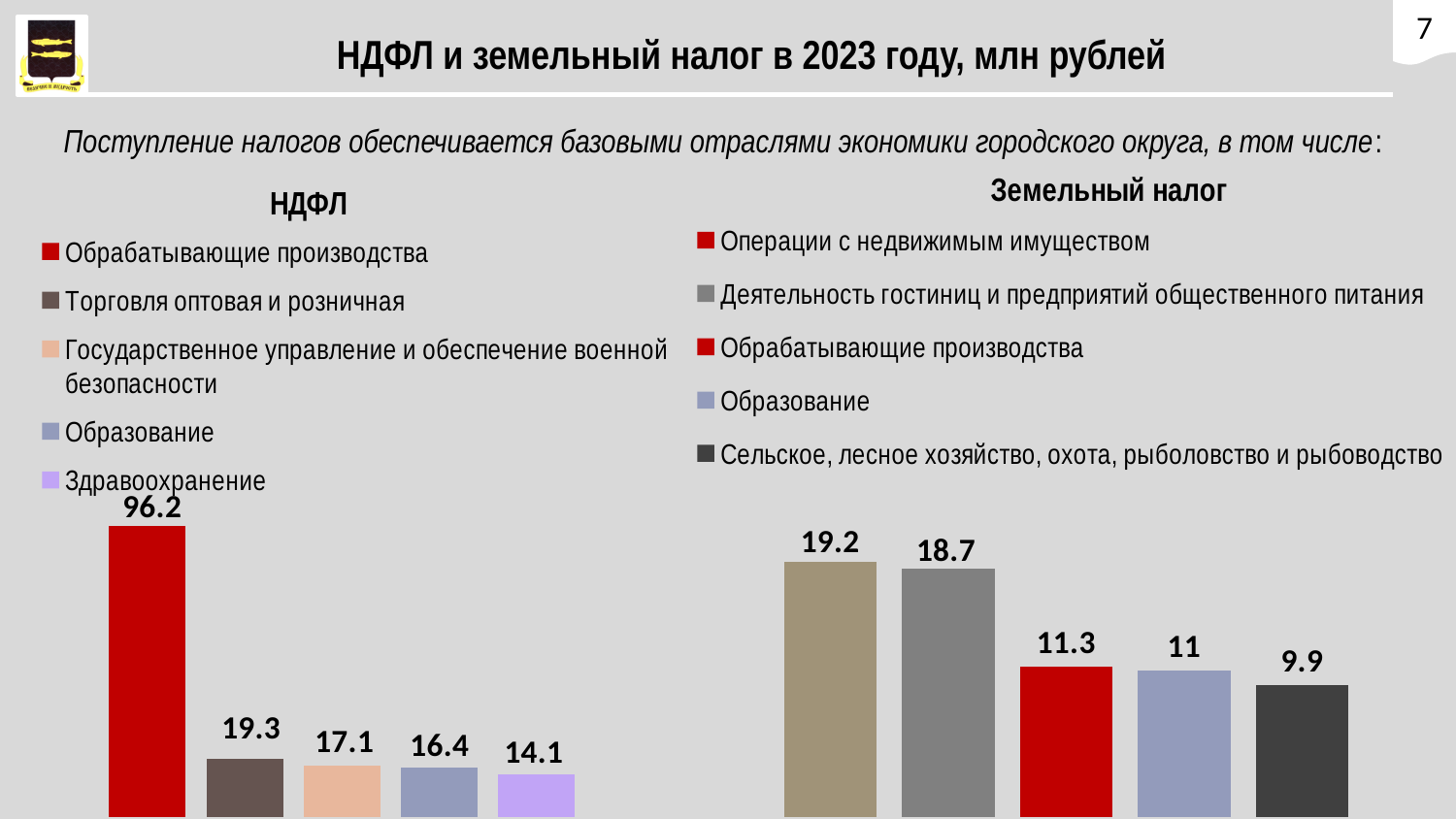
On the Земельный налог chart, what is the value of the first (leftmost) bar? 19.2 On the НДФЛ chart, what is the value for Обрабатывающие производства? 96.2 On the Земельный налог chart, what is the difference between the highest bar (19.2) and the lowest bar (9.9)? 9.3 On the НДФЛ chart, what is the difference between Торговля оптовая и розничная and Образование? 2.9 On the НДФЛ chart, which category has the lowest value? Здравоохранение On the Земельный налог chart, which is larger: Обрабатывающие производства or Образование? Обрабатывающие производства On the Земельный налог chart, what is the value for Сельское, лесное хозяйство, охота, рыболовство и рыбоводство? 9.9 On the НДФЛ chart, which category has the highest value? Обрабатывающие производства On the НДФЛ chart, how many bars are plotted? 5 On the НДФЛ chart, what is the value for Здравоохранение? 14.1 What type of chart is used for the Земельный налог data? Bar chart On the Земельный налог chart, what is the value for Деятельность гостиниц и предприятий общественного питания? 18.7